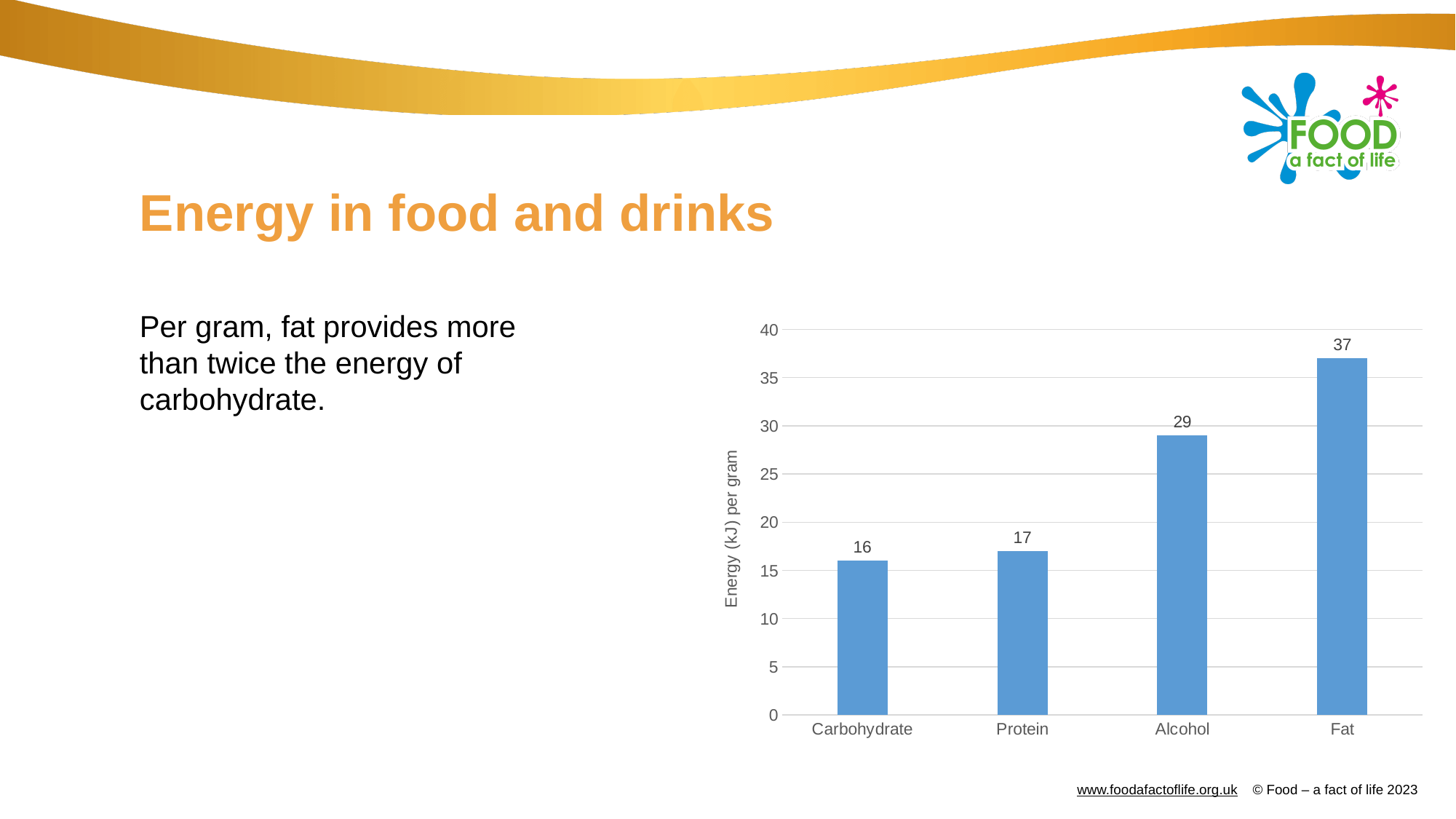
What is the energy (kJ) per gram value for Fat? 37 What is the difference in energy per gram between Alcohol and Protein? 12 What is the energy (kJ) per gram value for Protein? 17 Which category has the lowest energy per gram? Carbohydrate Which has a higher energy per gram, Alcohol or Protein? Alcohol What is the energy (kJ) per gram value for Alcohol? 29 What kind of chart is shown on the slide? Bar chart What is the energy (kJ) per gram value for Carbohydrate? 16 How many categories are shown on the chart? 4 What is the difference in energy per gram between Fat and Carbohydrate? 21 Which category has the highest energy per gram? Fat What is the label on the vertical axis of the chart? Energy (kJ) per gram